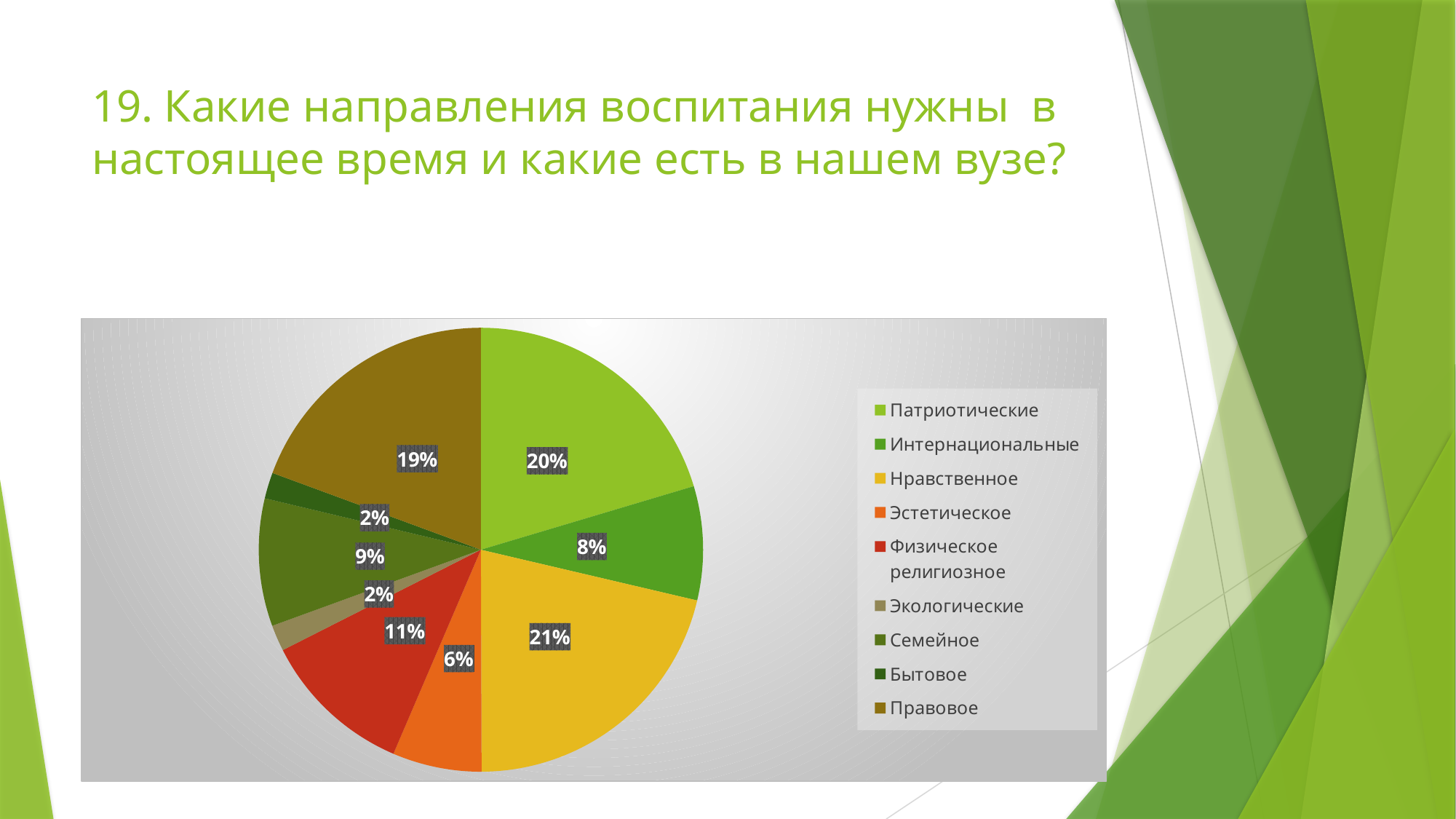
What is the difference between the shares for Нравственное and Правовое? 2% Which is larger, the share for Интернациональные or the share for Семейное? Семейное What kind of chart is shown on the slide? pie chart How many categories does the legend of the pie chart list? 9 What share of the pie does Семейное have? 9% What share of the pie does Нравственное have? 21% What share of the pie does Эстетическое have? 6% What share of the pie does Патриотические have? 20% What share of the pie does Правовое have? 19% What colour is the slice for Правовое in the pie chart? brown What share of the pie does Физическое религиозное have? 11% Which category has the largest share of the pie? Нравственное